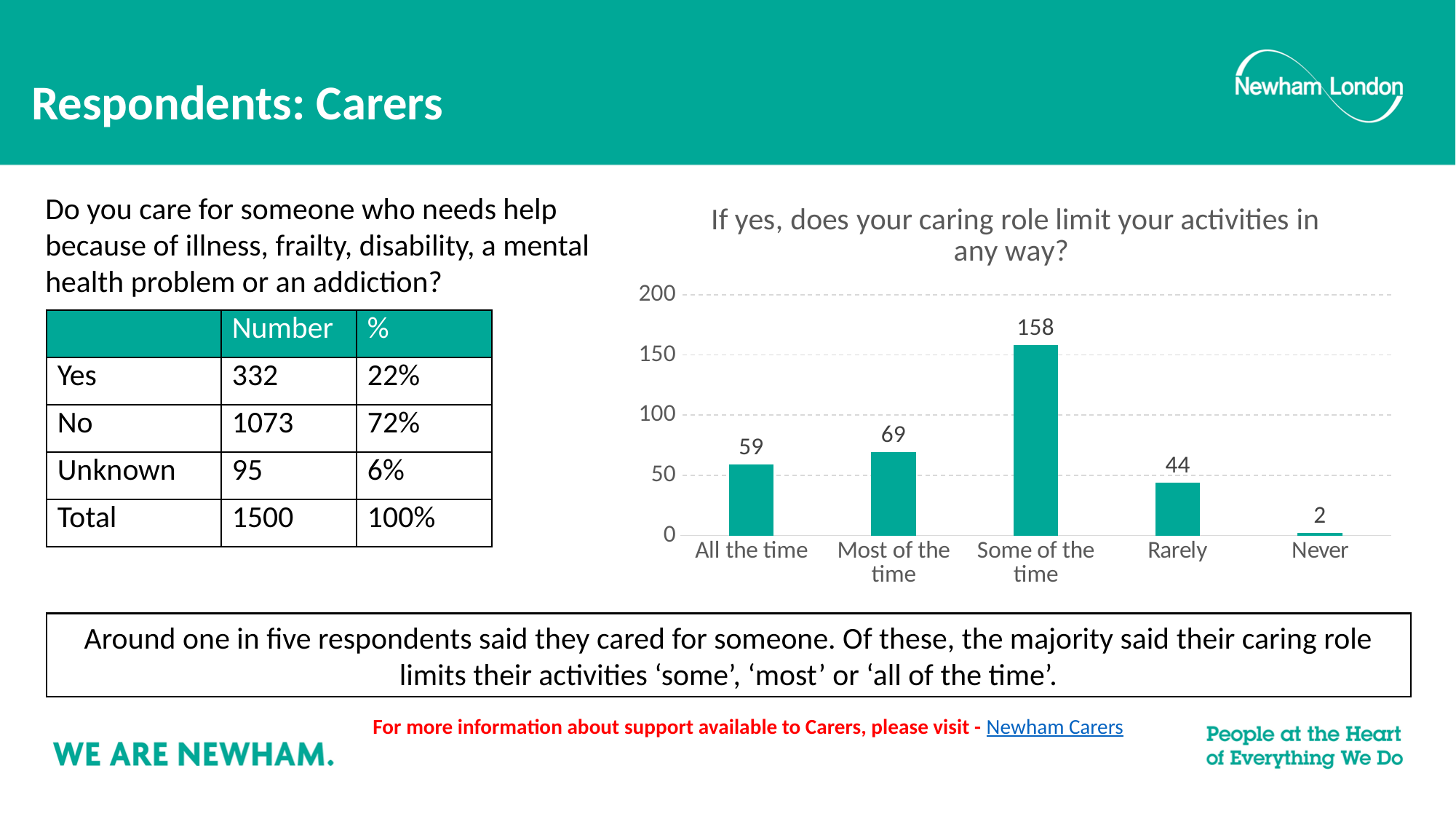
What is the difference between the values for 'All the time' and 'Rarely'? 15 Which category has the lowest value in the chart? Never Which is larger, the value for 'Most of the time' or the value for 'Rarely'? Most of the time What is the title of the chart? If yes, does your caring role limit your activities in any way? What is the value for 'Never' in the chart? 2 What is the difference between the values for 'Some of the time' and 'Most of the time'? 89 Which category has the highest value in the chart? Some of the time What kind of chart is shown on the slide? bar chart What is the value for 'Some of the time' in the chart? 158 What is the value for 'All the time' in the chart? 59 How many categories are shown on the x axis of the chart? 5 Is the value for 'Some of the time' greater or less than 150? greater